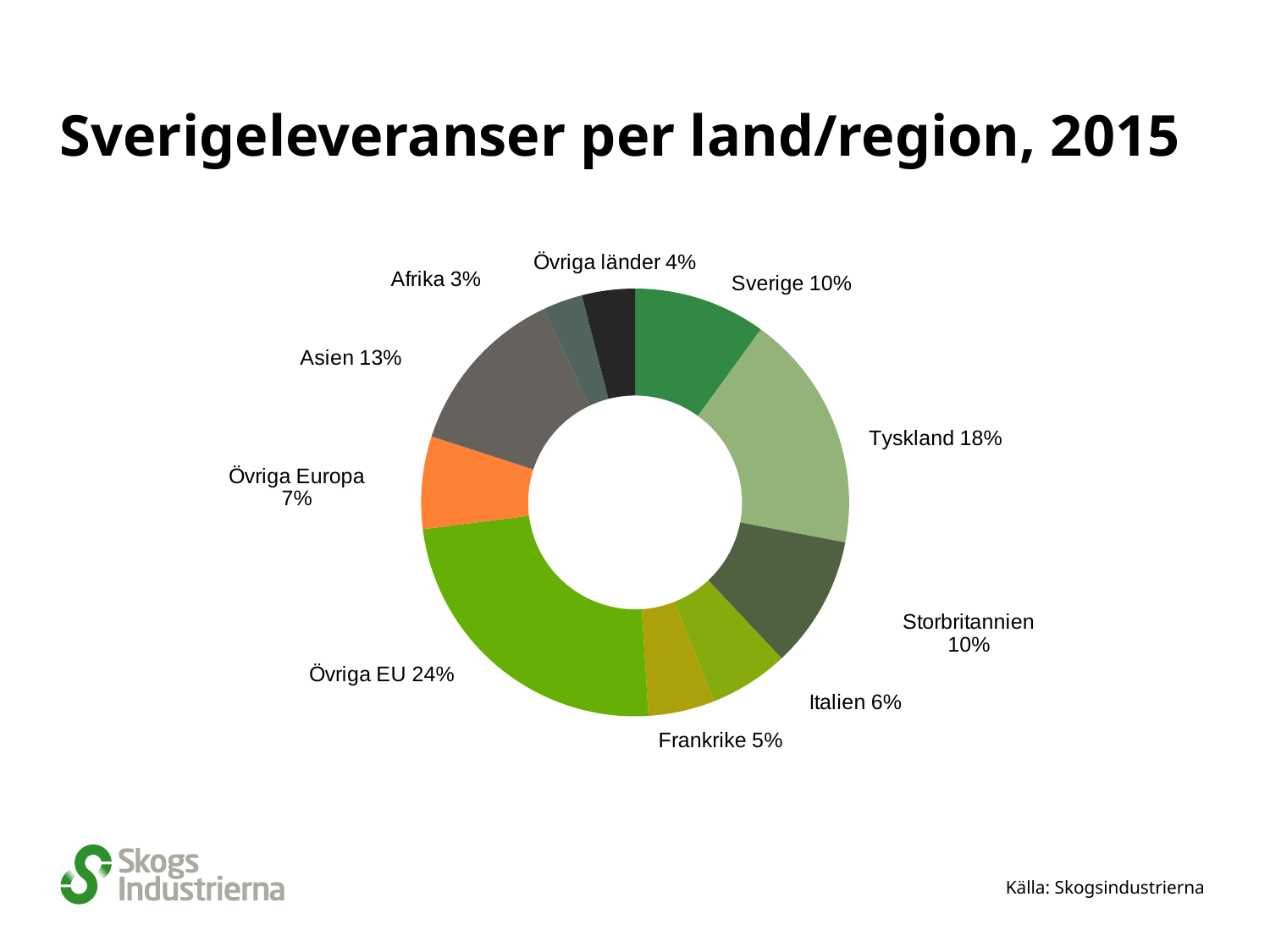
What is the difference in percentage points between Tyskland and Sverige? 8 What kind of chart is shown on the slide? Pie chart (doughnut) Which country or region has the smallest share of the chart? Afrika How many countries or regions are shown in the chart? 10 What share is shown for Frankrike? 5% Which has a larger share, Asien or Övriga Europa? Asien What is the title of the slide? Sverigeleveranser per land/region, 2015 Which country or region has the largest share of the chart? Övriga EU What source is cited for the chart? Skogsindustrierna What share of Sverigeleveranser went to Tyskland in 2015? 18% What percentage is shown for Asien? 13% What share is shown for Övriga EU? 24%